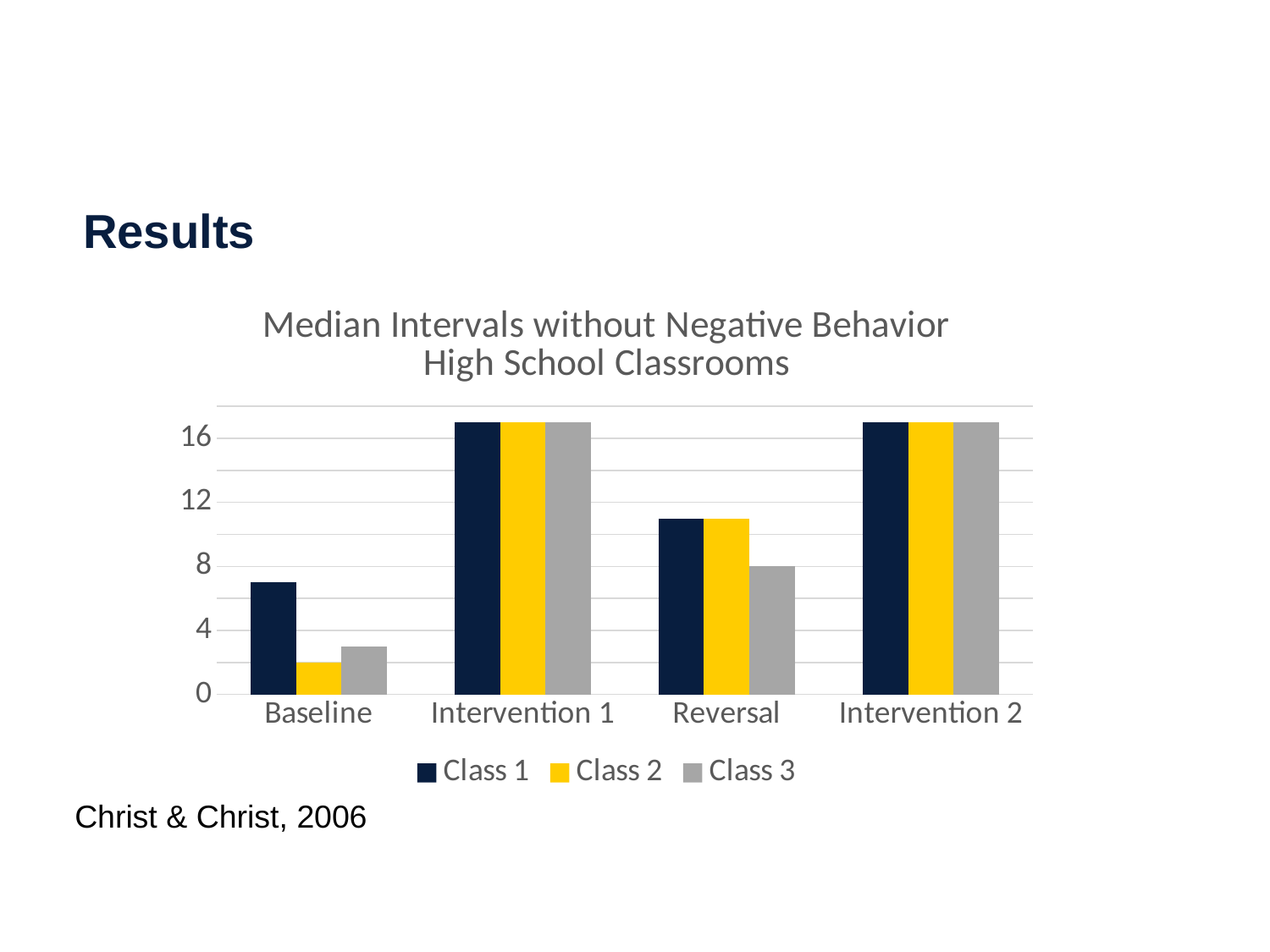
What is the title of the chart? Median Intervals without Negative Behavior High School Classrooms How many series does the legend list? 3 Is the value for Class 2 at Baseline greater or less than 4? less How many categories are shown along the x axis? 4 What kind of chart is shown on the slide? bar chart Which is larger: the Class 1 value at Baseline or the Class 1 value at Reversal? Reversal Is the value for Class 1 at Baseline greater or less than 4? greater Which series is shown in yellow in the legend? Class 2 Is the value for Class 1 at Intervention 1 greater or less than 16? greater In the Baseline category, which class has the highest value? Class 1 In the Reversal category, which class has the lowest value? Class 3 In the Baseline category, which class has the lowest value? Class 2